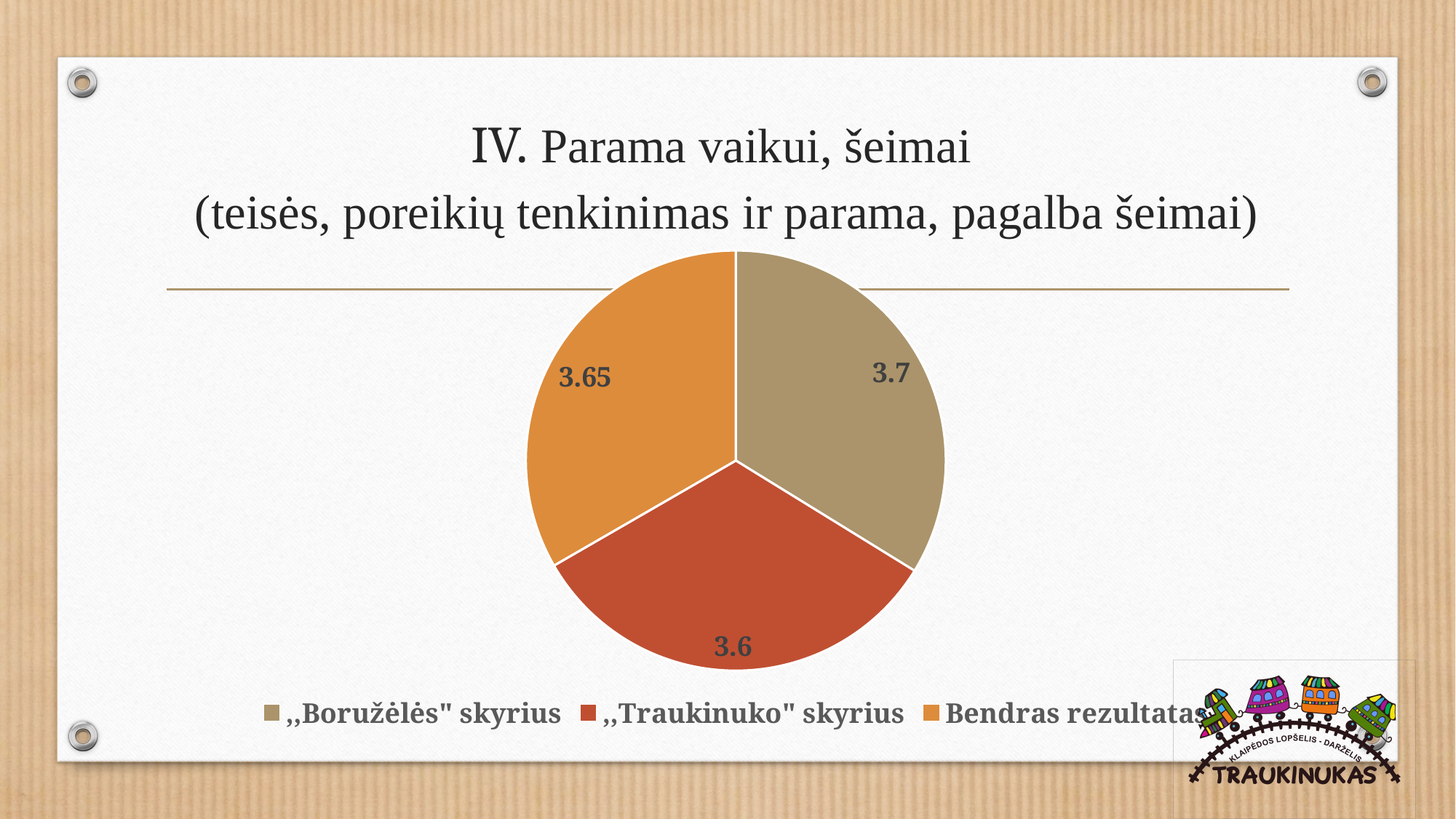
What is the value for Bendras rezultatas? 3.65 What is the difference between the values for „Boružėlės" skyrius and Bendras rezultatas? 0.05 How many slices does the pie chart have? 3 What colour is the slice for Bendras rezultatas? orange Which category has the highest value? „Boružėlės" skyrius How many entries does the legend list? 3 What is the value for „Traukinuko" skyrius? 3.6 What is the value for „Boružėlės" skyrius? 3.7 Which is larger, the value for „Traukinuko" skyrius or Bendras rezultatas? Bendras rezultatas What type of chart is shown on the slide? pie chart Which category has the lowest value? „Traukinuko" skyrius What is the difference between the values for „Boružėlės" skyrius and „Traukinuko" skyrius? 0.1